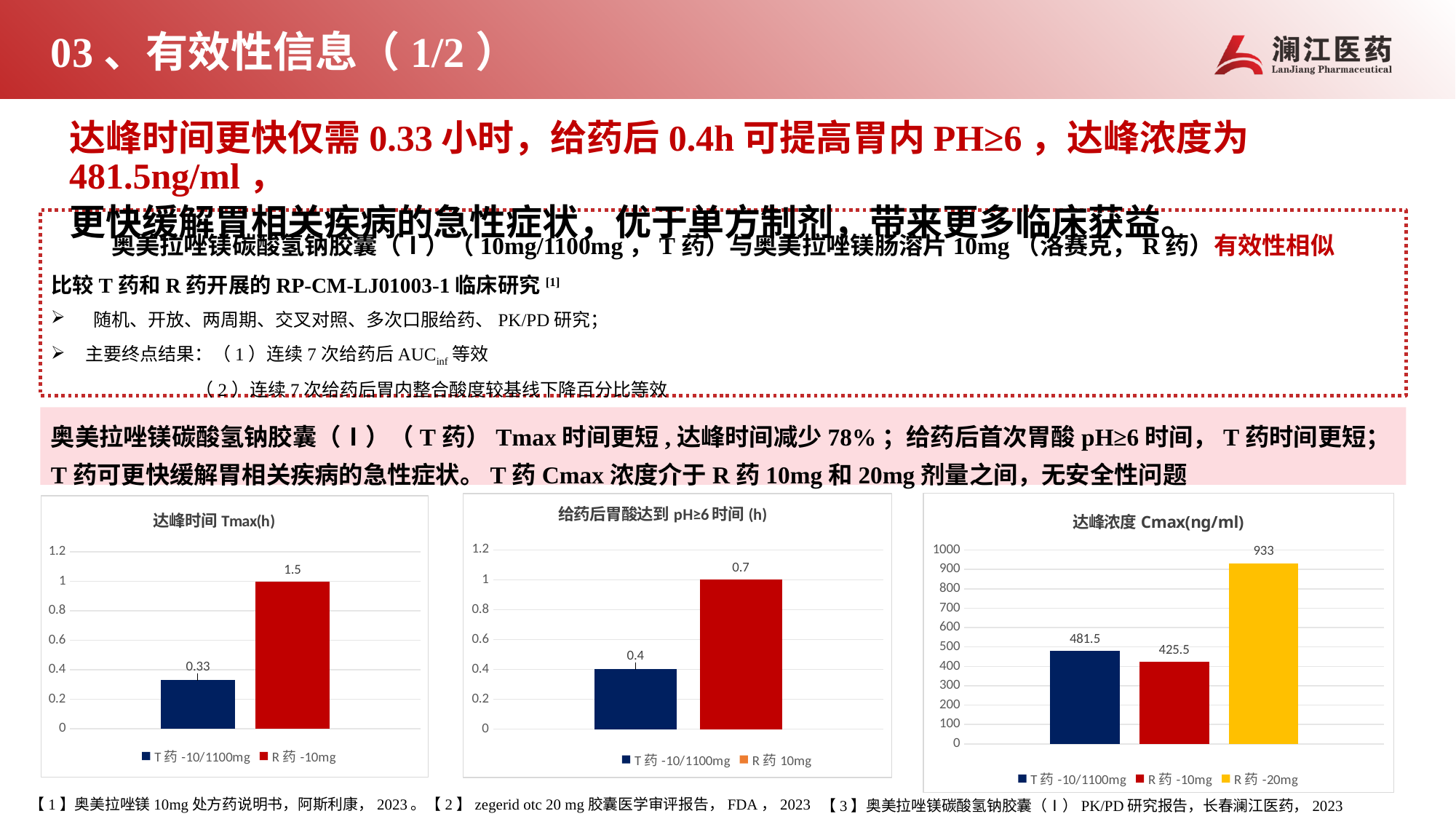
How many series does the legend of the 达峰浓度 Cmax(ng/ml) chart list? 3 In the 给药后胃酸达到pH≥6时间(h) chart, what is the value for T药-10/1100mg? 0.4 In the 达峰浓度 Cmax(ng/ml) chart, what is the difference between the T药-10/1100mg value and the R药-10mg value? 56 In the 达峰浓度 Cmax(ng/ml) chart, what is the value for T药-10/1100mg? 481.5 In the 给药后胃酸达到pH≥6时间(h) chart, what is the value for R药 10mg? 0.7 In the 达峰浓度 Cmax(ng/ml) chart, what is the value for R药-20mg? 933 In the 给药后胃酸达到pH≥6时间(h) chart, what is the difference between the R药 10mg value and the T药-10/1100mg value? 0.3 In the 达峰时间 Tmax(h) chart, what is the value for R药-10mg? 1.5 In the 达峰浓度 Cmax(ng/ml) chart, which series has the highest value? R药-20mg In the 达峰时间 Tmax(h) chart, what is the value for T药-10/1100mg? 0.33 What type of chart is the 达峰时间 Tmax(h) chart? Bar chart In the 达峰时间 Tmax(h) chart, which series has the lower value? T药-10/1100mg